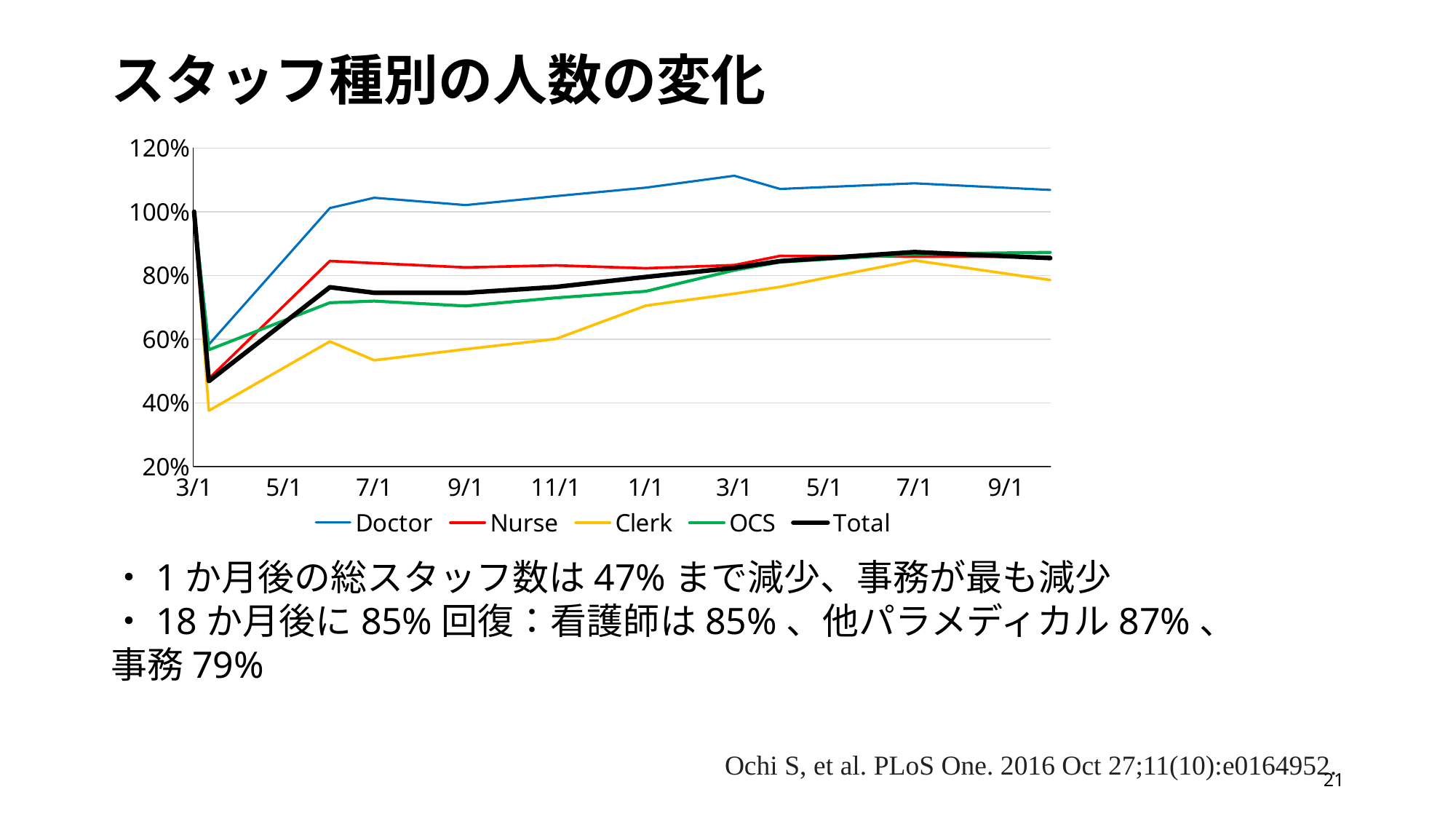
What is the value of the Total series at the first 3/1 point on the x axis? 100% What type of chart is shown on the slide? line chart Is the value for OCS at the first 9/1 point greater or less than 80%? less Which series drops to the lowest value at the second point (just after the first 3/1)? Clerk Does the Clerk series rise or fall between the second 5/1 point and the second 7/1 point? rise Which series has the lowest value at the last point on the x axis? Clerk Is the value for Clerk at the first 7/1 point greater or less than 60%? less How many series does the legend list? 5 At the first 7/1 point, which is larger, the Doctor value or the Nurse value? Doctor Which series has the highest value at the last point on the x axis? Doctor Is the value for Doctor at 1/1 greater or less than 100%? greater What are the series names listed in the legend? Doctor, Nurse, Clerk, OCS, Total